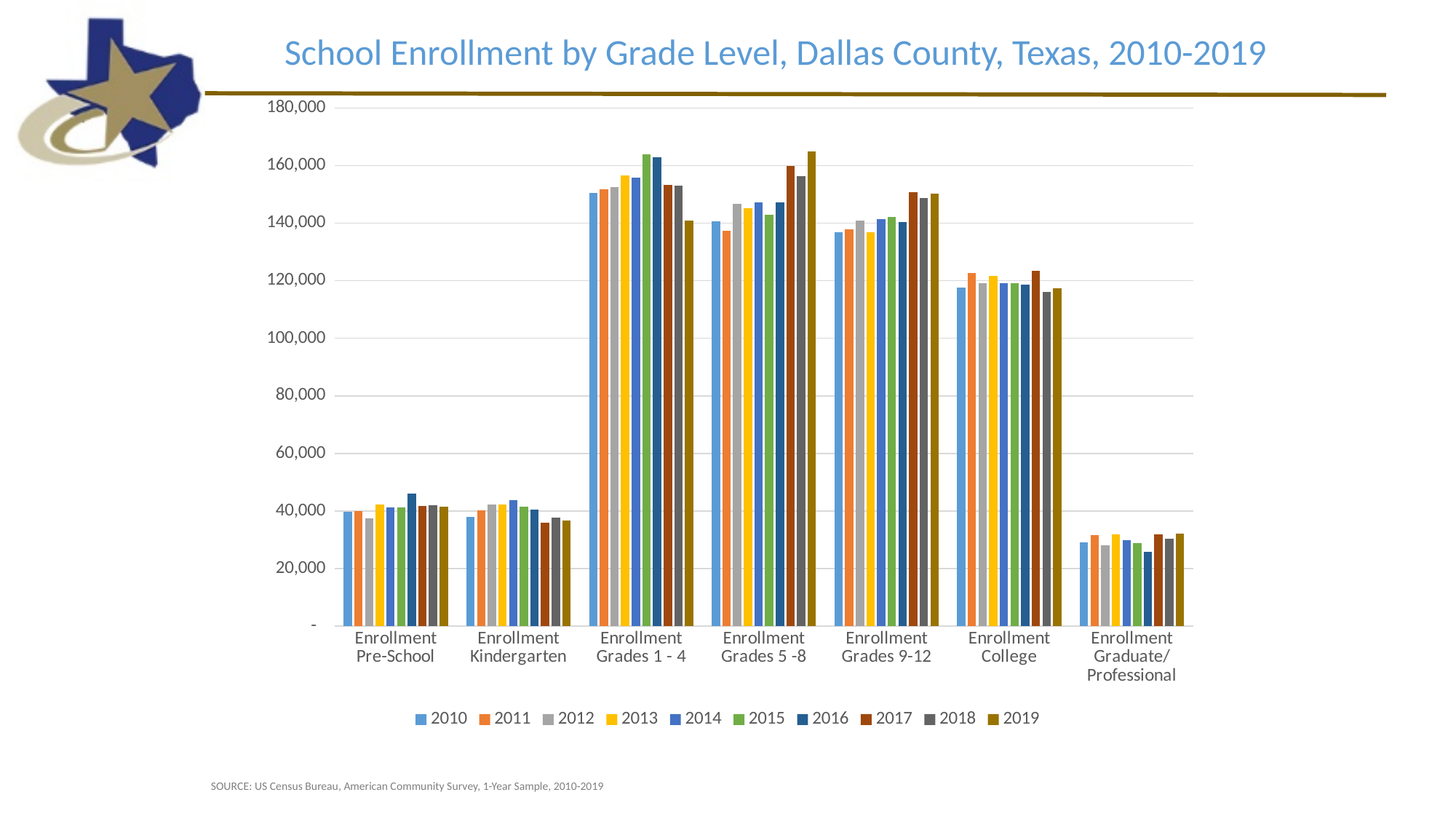
Within the Enrollment Grades 5 -8 category, which year has the highest enrollment? 2019 Which grade-level category has the lowest enrollment across all years? Enrollment Graduate/Professional For 2010, which is larger: Enrollment Grades 1 - 4 or Enrollment Grades 5 -8? Enrollment Grades 1 - 4 Is the 2017 value for Enrollment College greater or less than 120,000? greater Within the Enrollment College category, which year has the lowest enrollment? 2018 How many grade-level categories are shown on the x axis? 7 How many series (years) does the legend list? 10 What kind of chart is shown on the slide? Bar chart What is the title of the chart? School Enrollment by Grade Level, Dallas County, Texas, 2010-2019 Is the 2016 value for Enrollment Graduate/Professional greater or less than 30,000? less Is the 2015 value for Enrollment Grades 1 - 4 greater or less than 160,000? greater